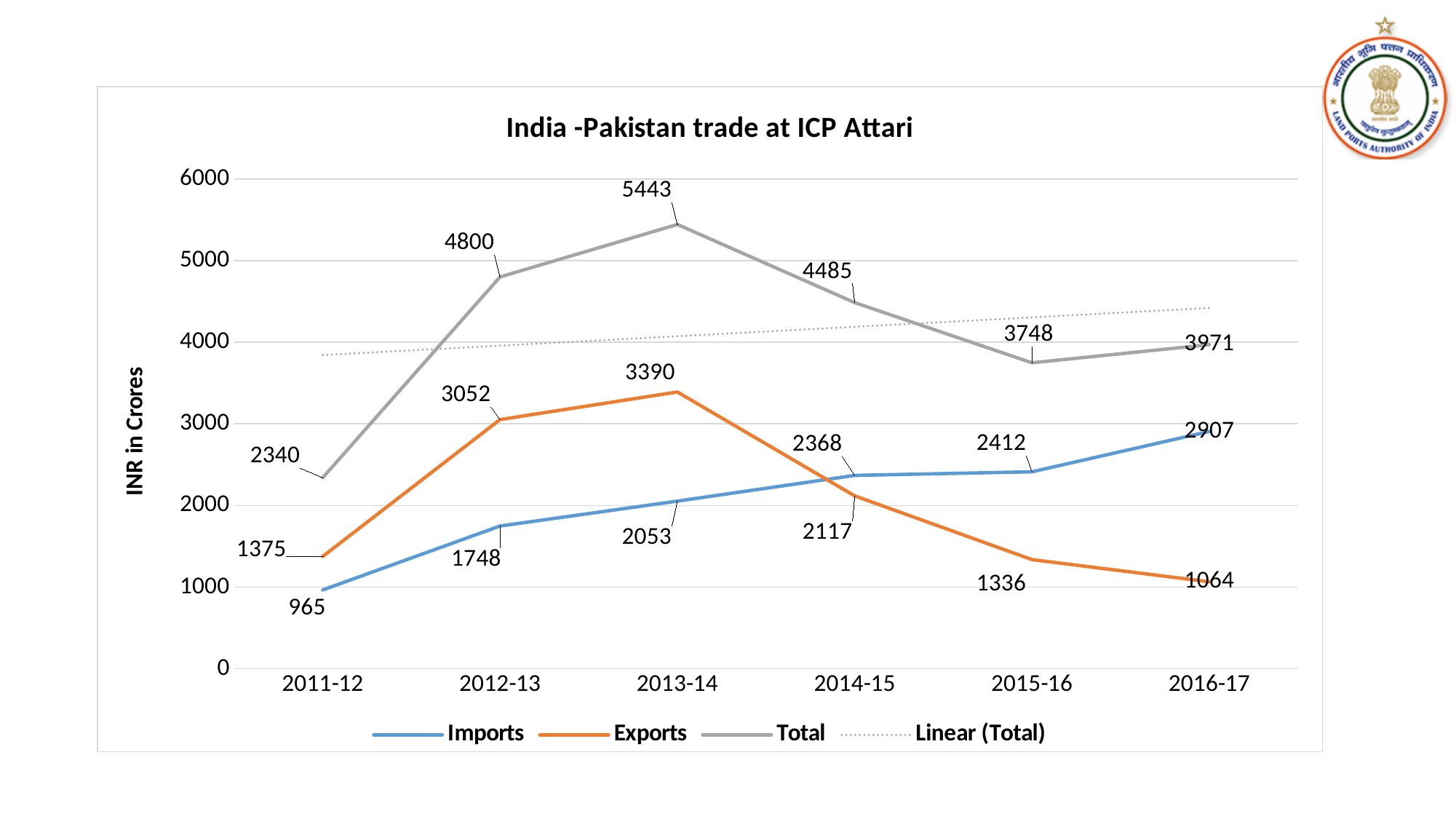
How many series does the legend list? 4 How many years are shown on the x axis? 6 In which year is the Total highest? 2013-14 What is the value of Exports in 2013-14? 3390 What is the difference between Exports and Imports in 2012-13? 1304 Do the Imports values rise or fall from 2011-12 to 2016-17? rise What is the title of the chart? India -Pakistan trade at ICP Attari What is the Total value in 2016-17? 3971 Which is larger in 2015-16, Imports or Exports? Imports What is the value of Imports in 2011-12? 965 In which year is the Exports value lowest? 2016-17 What kind of chart is this? line chart